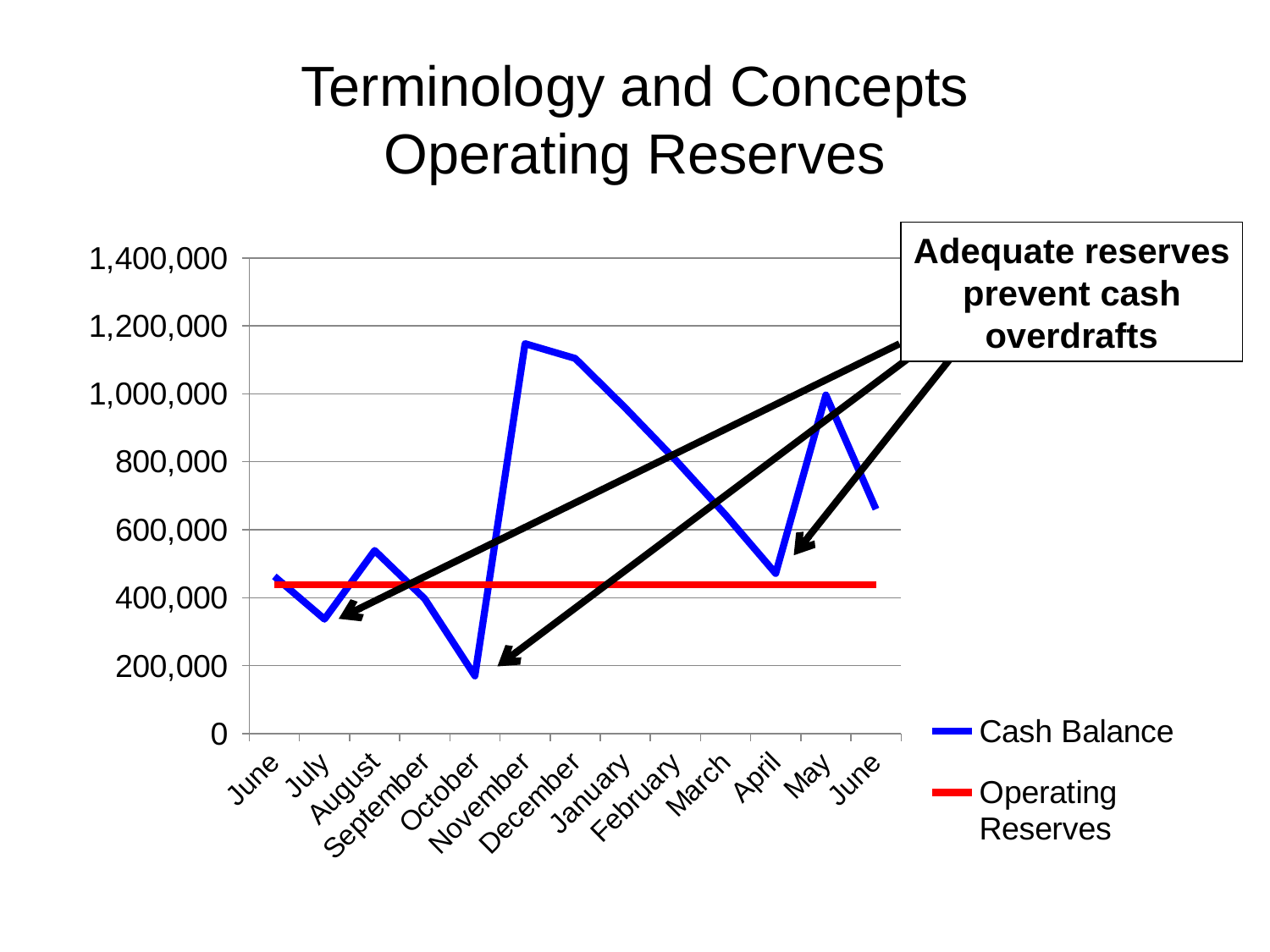
Is the Cash Balance for October greater or less than 200,000? less What colour is the Operating Reserves line? red Does the Cash Balance rise or fall from December to April? fall Is the Cash Balance for November greater or less than 1,000,000? greater How many months are shown along the x axis? 13 Which is larger, the Cash Balance in November or in May? November Is the Cash Balance for May greater or less than 800,000? greater In which month is the Cash Balance highest? November How many series does the legend list? 2 In which month is the Cash Balance lowest? October What kind of chart is shown on the slide? line chart